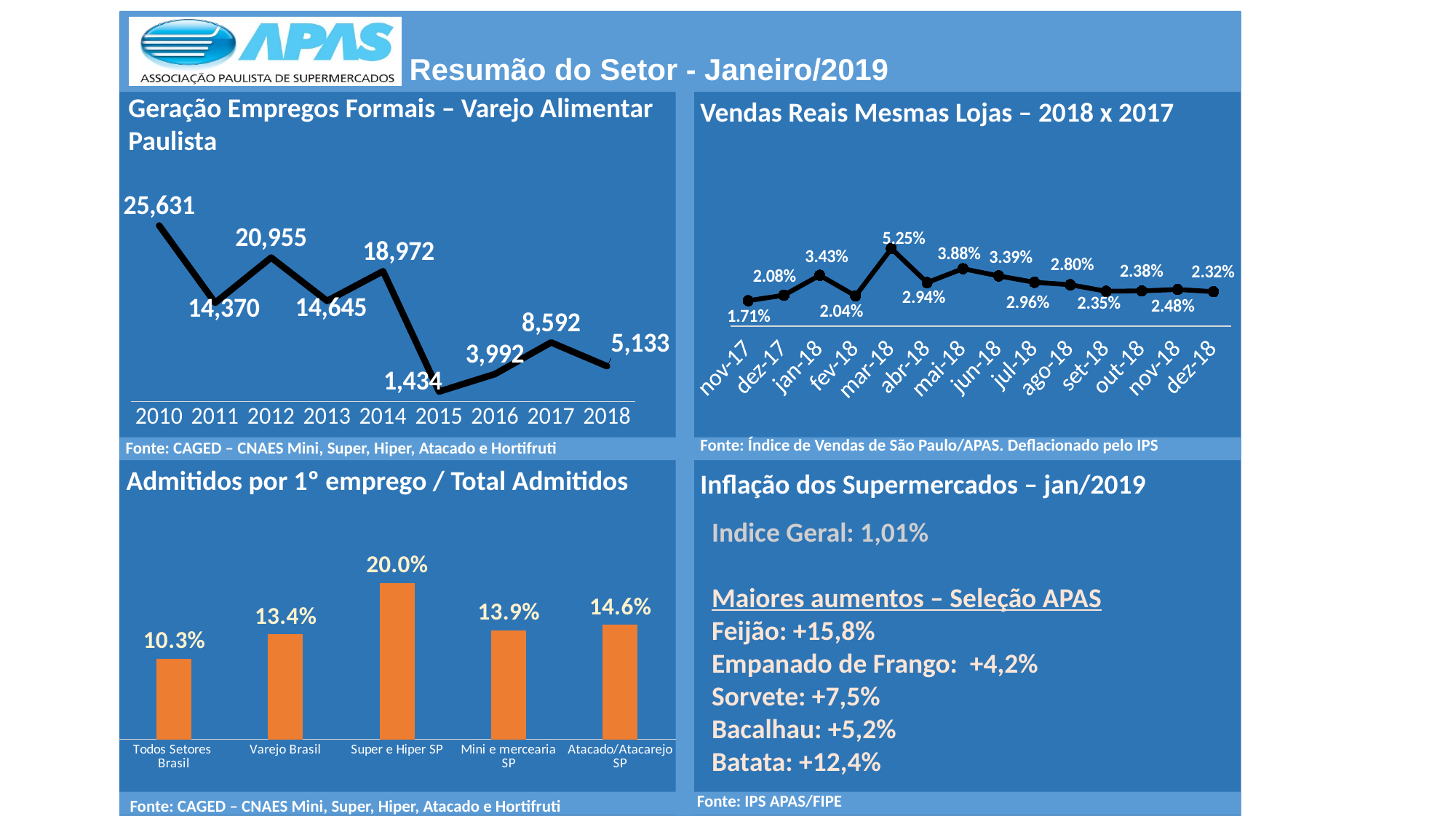
In the 'Geração Empregos Formais – Varejo Alimentar Paulista' chart, what is the difference between the 2017 and 2018 values? 3,459 In the 'Vendas Reais Mesmas Lojas – 2018 x 2017' chart, which is larger, the value for jan-18 or the value for jun-18? jan-18 In the 'Geração Empregos Formais – Varejo Alimentar Paulista' chart, which year has the lowest value? 2015 In the 'Geração Empregos Formais – Varejo Alimentar Paulista' chart, how many years are plotted? 9 In the 'Vendas Reais Mesmas Lojas – 2018 x 2017' chart, what is the value for mar-18? 5.25% In the 'Vendas Reais Mesmas Lojas – 2018 x 2017' chart, how many data points are plotted? 14 In the 'Admitidos por 1° emprego / Total Admitidos' chart, what is the difference between Atacado/Atacarejo SP and Varejo Brasil? 1.2% In the 'Geração Empregos Formais – Varejo Alimentar Paulista' chart, what is the value for 2010? 25,631 What type of chart is 'Geração Empregos Formais – Varejo Alimentar Paulista'? Line chart In the 'Admitidos por 1° emprego / Total Admitidos' chart, what is the value for Super e Hiper SP? 20.0% In the 'Vendas Reais Mesmas Lojas – 2018 x 2017' chart, which month has the lowest value? nov-17 In the 'Admitidos por 1° emprego / Total Admitidos' chart, which category has the lowest value? Todos Setores Brasil